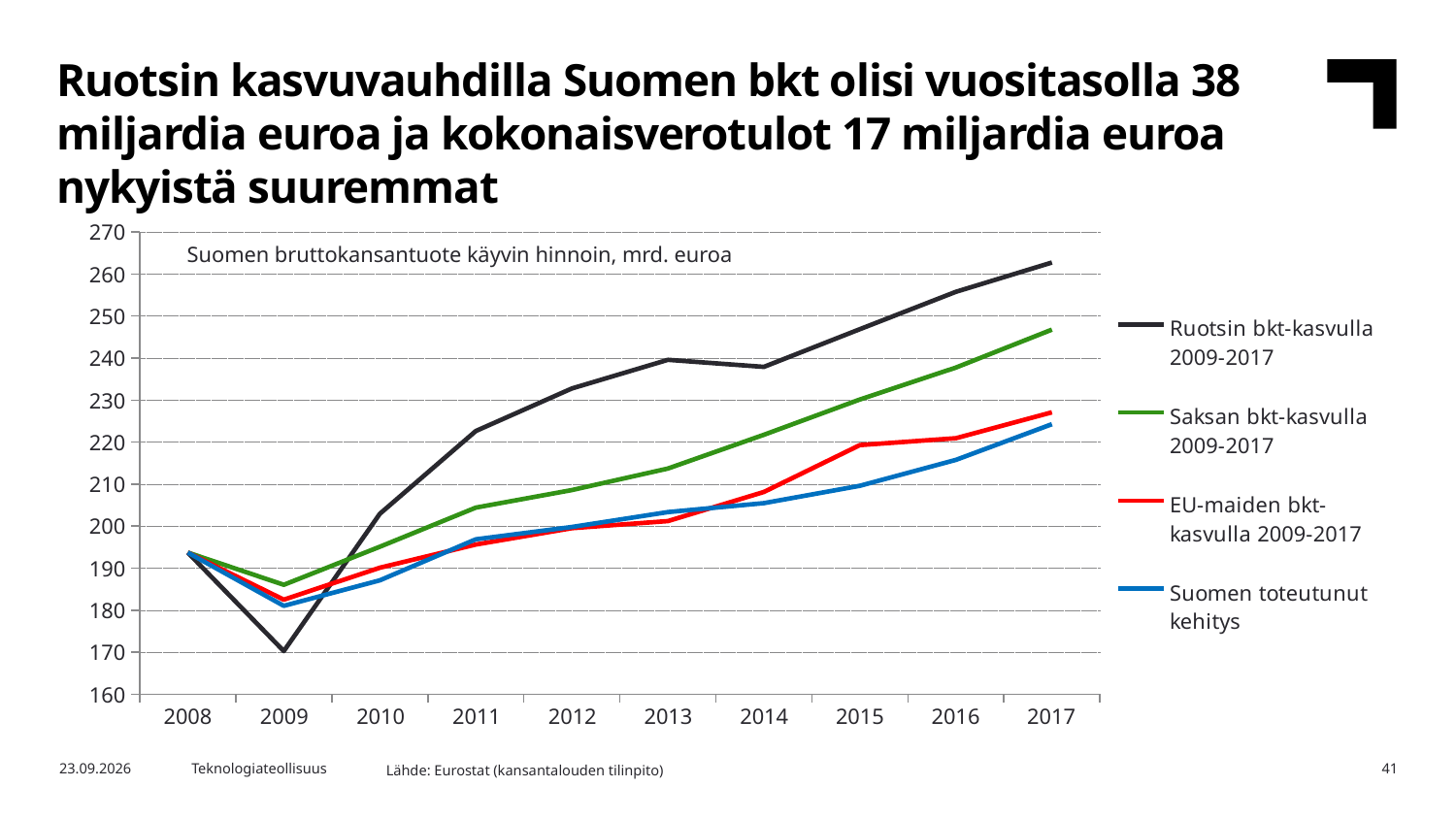
Does the Ruotsin bkt-kasvulla 2009-2017 line rise or fall from 2009 to 2017? rise Is the value for Suomen toteutunut kehitys in 2017 greater or less than 230? less Which series has the lowest value in 2009? Ruotsin bkt-kasvulla 2009-2017 Is the value for Saksan bkt-kasvulla 2009-2017 in 2017 greater or less than 240? greater Is the value for Ruotsin bkt-kasvulla 2009-2017 in 2009 greater or less than 180? less What type of chart is shown on the slide? line chart How many series does the legend list? 4 In 2017, which is larger: Saksan bkt-kasvulla 2009-2017 or EU-maiden bkt-kasvulla 2009-2017? Saksan bkt-kasvulla 2009-2017 Which series has the highest value in 2017? Ruotsin bkt-kasvulla 2009-2017 What is the text shown inside the chart area describing the data? Suomen bruttokansantuote käyvin hinnoin, mrd. euroa How many years are shown on the x axis? 10